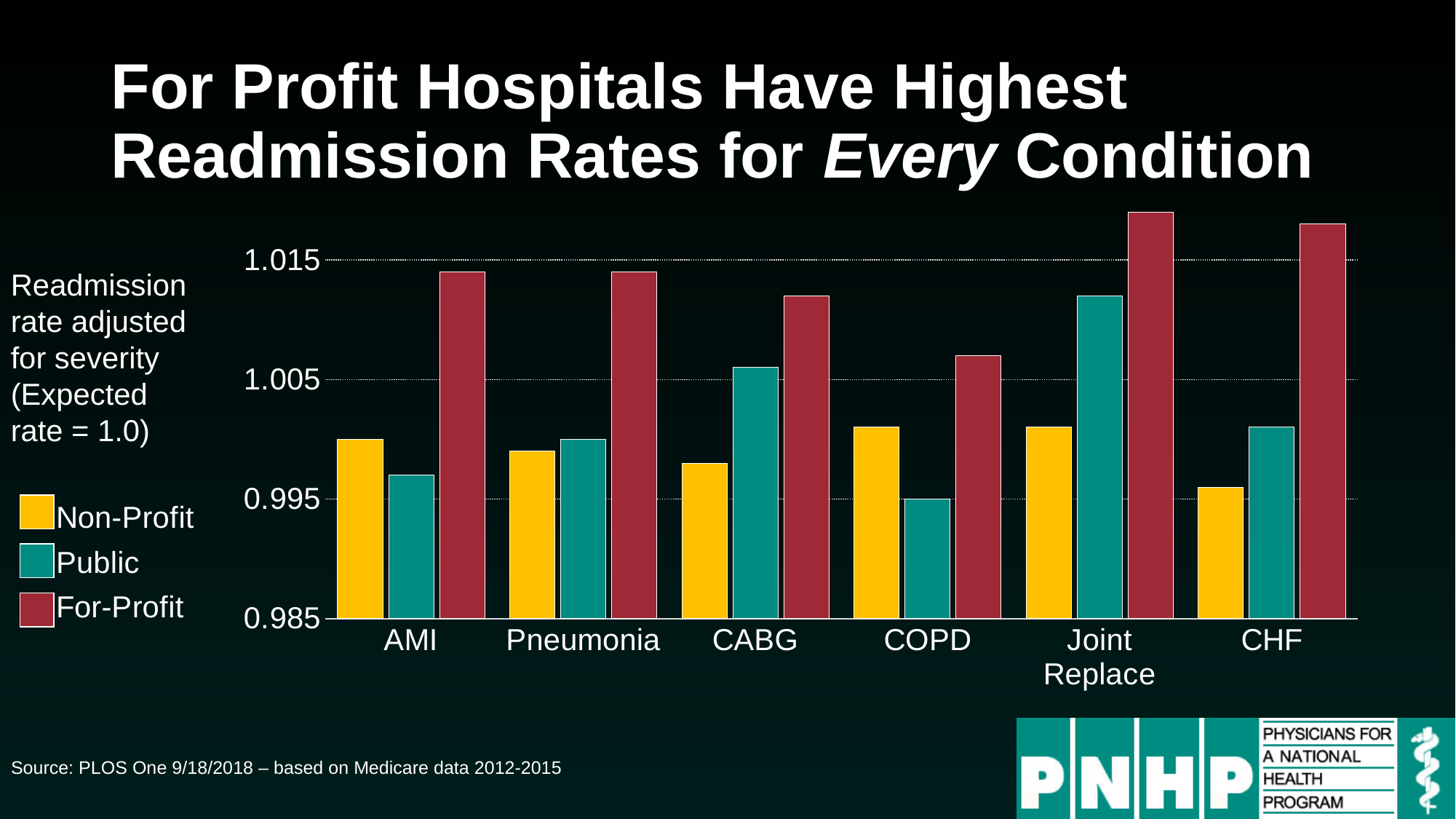
Is the Non-Profit value for AMI greater or less than 1.005? less How many series does the chart's legend list? 3 For which condition is the For-Profit readmission rate the highest? Joint Replace Is the Public value for CABG greater or less than 1.005? greater Which hospital type has the highest readmission rate for every condition in the chart? For-Profit What kind of chart is shown on the slide? bar chart Which is larger for COPD, the Non-Profit value or the Public value? Non-Profit Which colour represents the For-Profit series in the chart? red Is the For-Profit value for Joint Replace greater or less than 1.015? greater Which is larger for CHF, the Non-Profit value or the Public value? Public How many conditions are shown along the x axis of the chart? 6